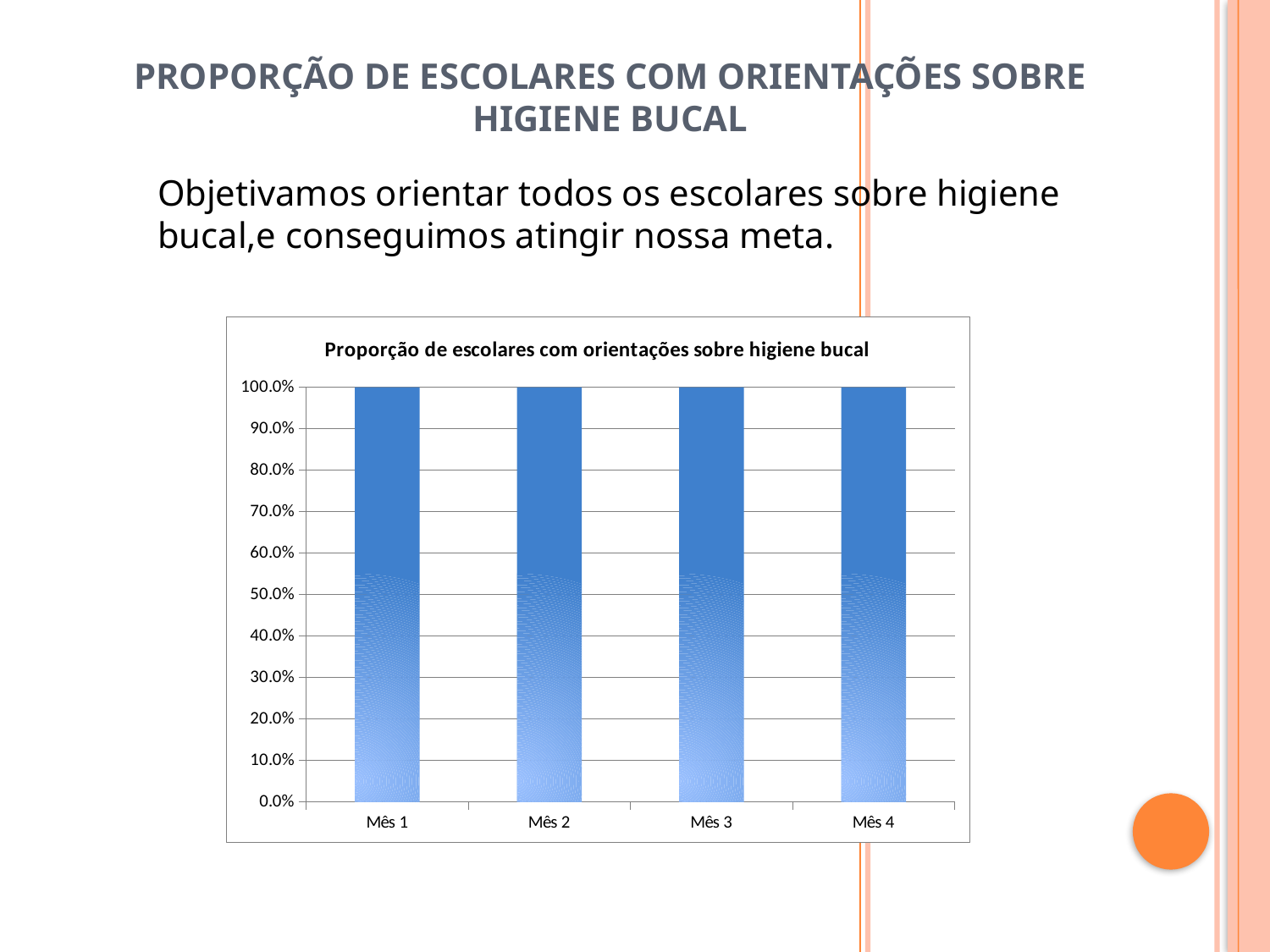
What is the highest value shown on the y axis? 100.0% Is the value for Mês 3 greater or less than 90.0%? greater What is the value for Mês 4? 100.0% What colour are the bars in the chart? Blue What is the value for Mês 3? 100.0% What kind of chart is this? Bar chart What is the title of the chart? Proporção de escolares com orientações sobre higiene bucal What is the value for Mês 1? 100.0% What is the value for Mês 2? 100.0% What is the difference between the values for Mês 1 and Mês 4? 0.0% Do the values rise, fall or stay the same from Mês 1 to Mês 4? Stay the same How many categories are shown on the x axis? 4